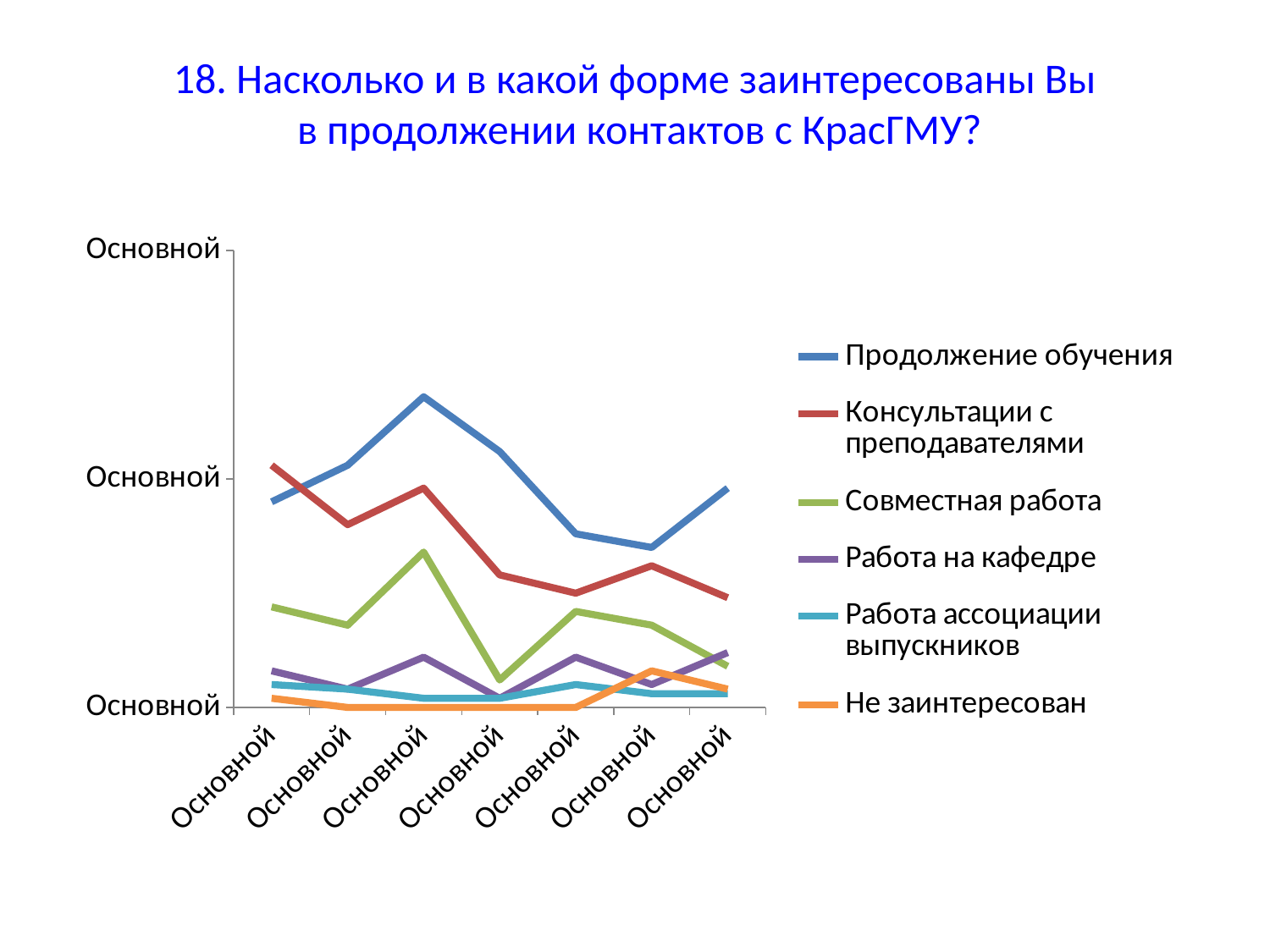
Which series is drawn in orange? Не заинтересован How many points are plotted along the x axis for each series? 7 How many series does the legend list? 6 Which series reaches the highest point on the chart? Продолжение обучения What kind of chart is shown on the slide? line chart What is the title of the slide above the chart? 18. Насколько и в какой форме заинтересованы Вы в продолжении контактов с КрасГМУ?